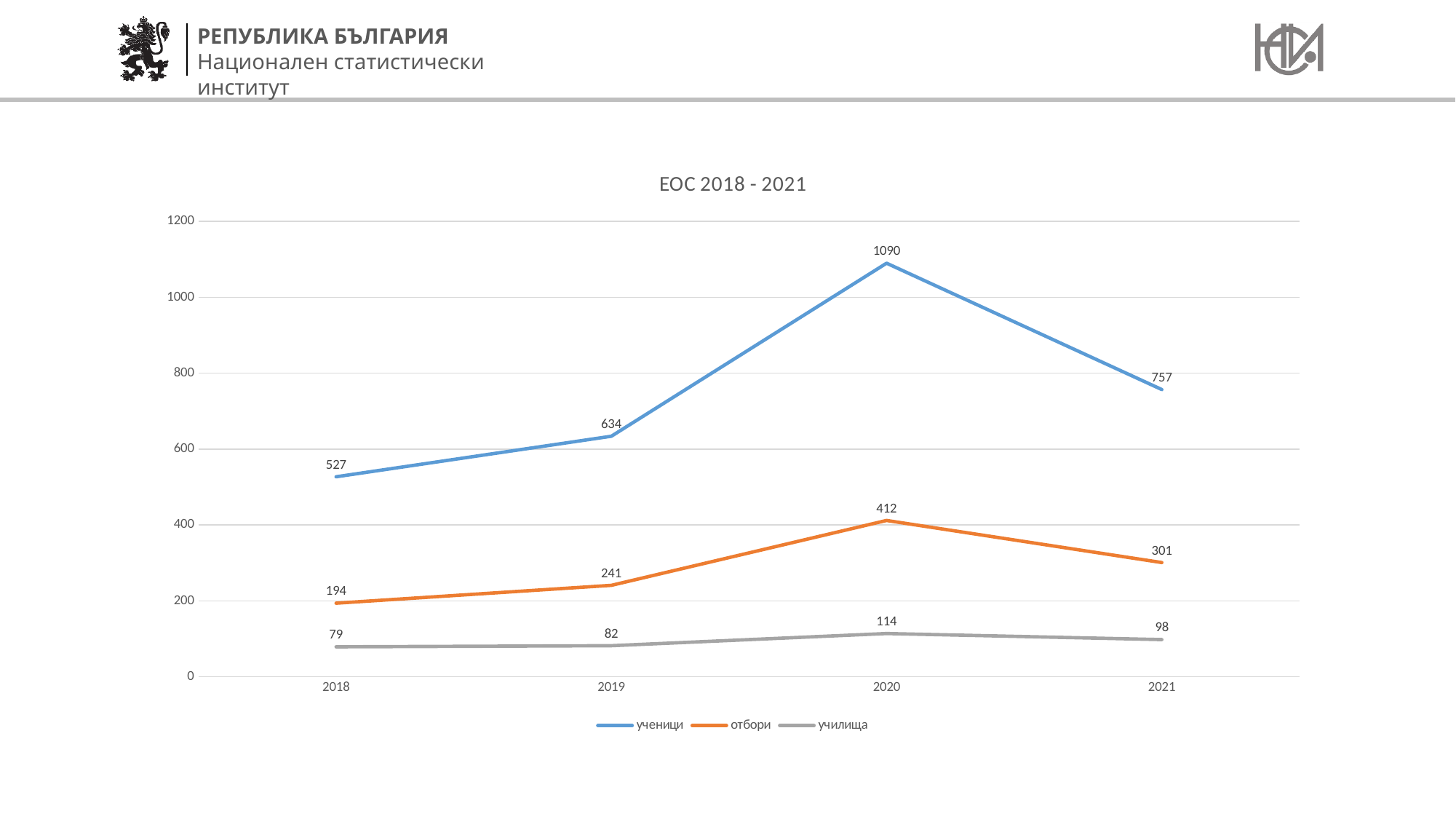
In which year is the value for училища lowest? 2018 What is the value for ученици in 2020? 1090 What is the difference between the ученици values in 2020 and 2021? 333 How many series does the legend list? 3 How many years are shown on the x axis? 4 Which is larger: отбори in 2018 or отбори in 2021? отбори in 2021 What is the value for училища in 2021? 98 Is the value for ученици in 2021 greater or less than 800? less What is the title of the chart? ЕОС 2018 - 2021 What kind of chart is shown? line chart In which year is the value for ученици highest? 2020 What is the value for отбори in 2019? 241